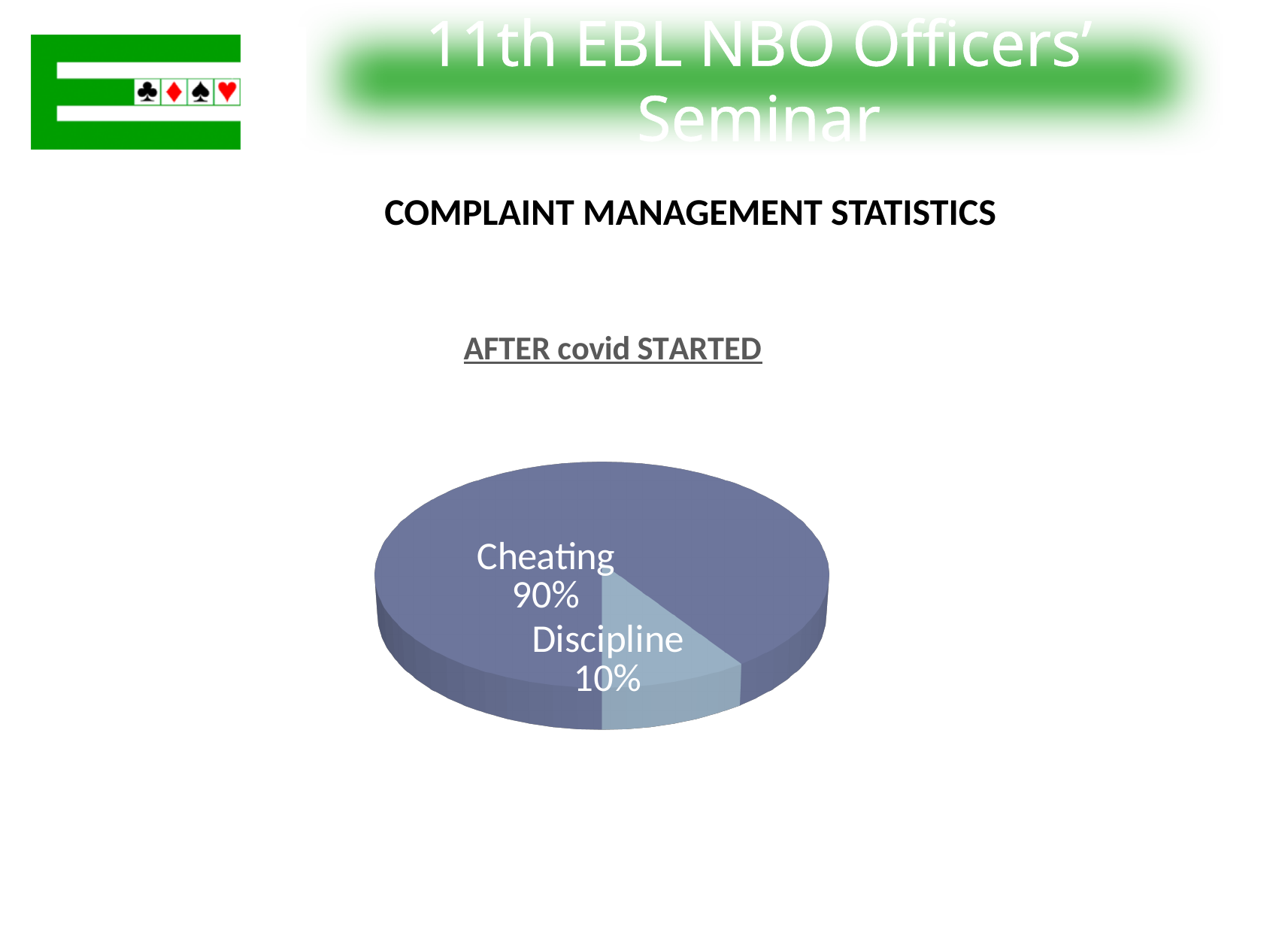
What is the combined share of the Cheating and Discipline slices? 100% Which category has the largest slice of the pie? Cheating Which is larger, the Cheating slice or the Discipline slice? Cheating What is the heading shown above the pie chart? AFTER covid STARTED What is the difference in percentage points between the Cheating and Discipline slices? 80 What is the title of the statistics section on the slide? COMPLAINT MANAGEMENT STATISTICS Which category has the smallest slice of the pie? Discipline What share of the pie does Cheating represent? 90% What kind of chart is shown on the slide? pie chart How many slices does the pie chart have? 2 What share of the pie does Discipline represent? 10%